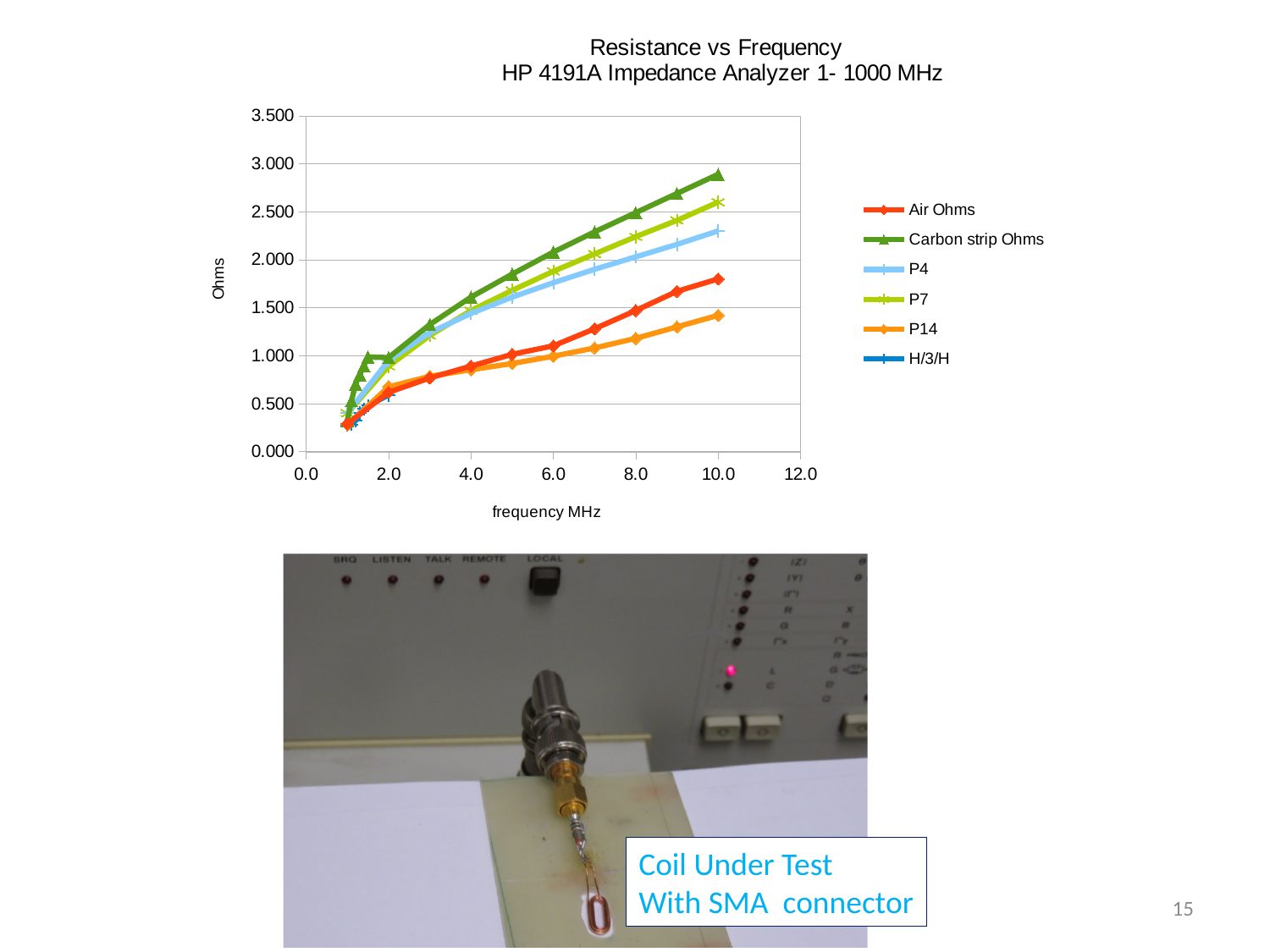
What kind of chart is shown on the slide? line chart Is the value for Air Ohms at 10.0 MHz greater or less than 1.500? greater At 10.0 MHz, which is larger: Carbon strip Ohms or Air Ohms? Carbon strip Ohms Which series has the highest resistance at 10.0 MHz? Carbon strip Ohms Which series has the lowest resistance at 10.0 MHz? P14 How many series does the chart legend list? 6 Is the value for P14 at 10.0 MHz greater or less than 1.000? greater What is the label of the x axis of the chart? frequency MHz Does the Carbon strip Ohms series rise or fall as frequency increases? rise Is the value for Carbon strip Ohms at 10.0 MHz greater or less than 2.500? greater At 10.0 MHz, which is larger: P4 or P14? P4 What is the title of the chart? Resistance vs Frequency HP 4191A Impedance Analyzer 1- 1000 MHz